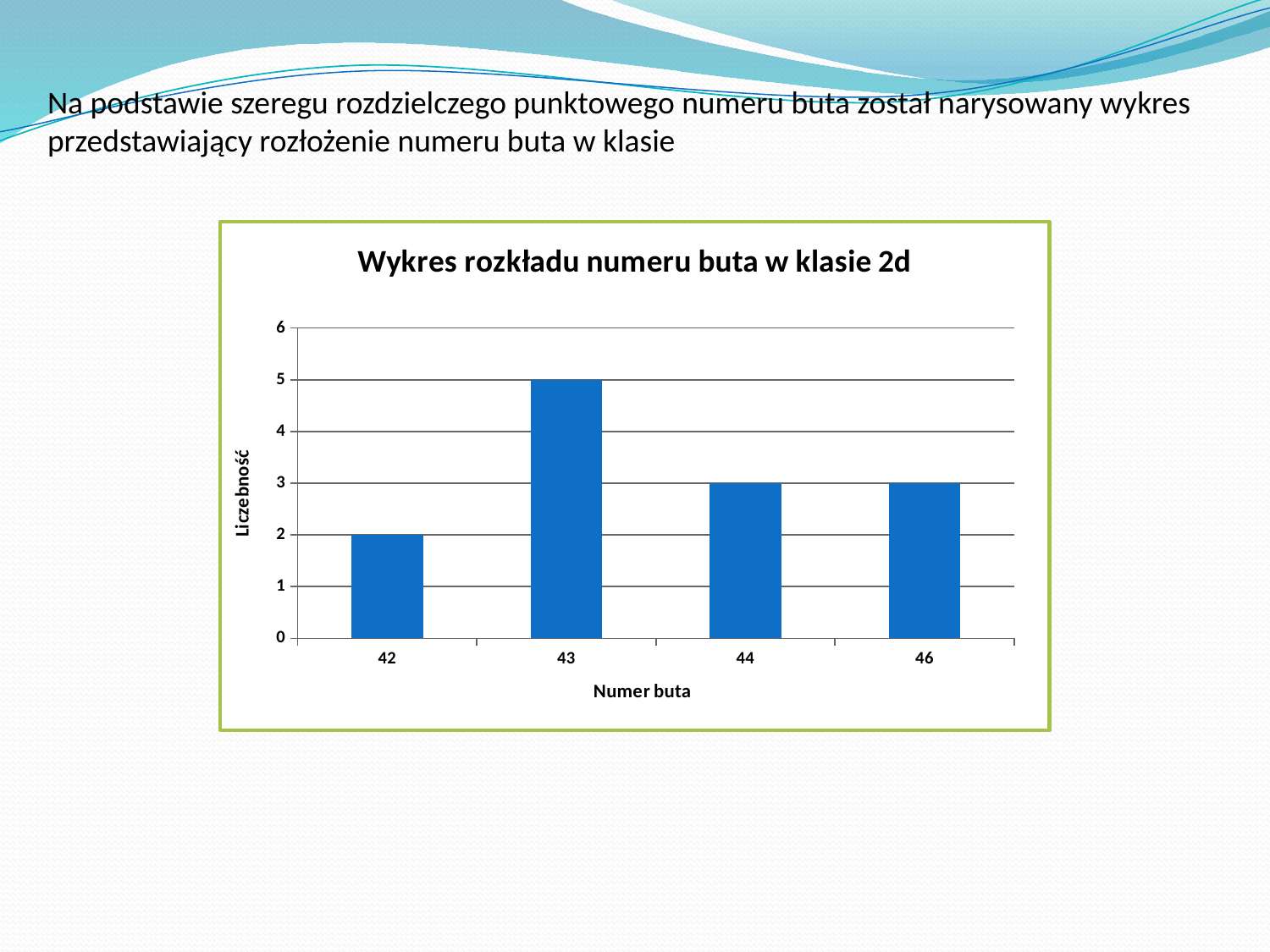
Is the value for shoe size 43 greater or less than 4? greater What is the value for shoe size 44? 3 What is the value for shoe size 43? 5 What is the title of the chart? Wykres rozkładu numeru buta w klasie 2d What is the difference between the values for shoe size 43 and shoe size 42? 3 Which shoe size has the lowest count? 42 Which shoe size has the highest count? 43 What is the value for shoe size 42? 2 Which is larger, the value for shoe size 43 or the value for shoe size 46? 43 How many shoe size categories are shown on the x axis? 4 What kind of chart is shown on the slide? bar chart What is the label of the y axis? Liczebność